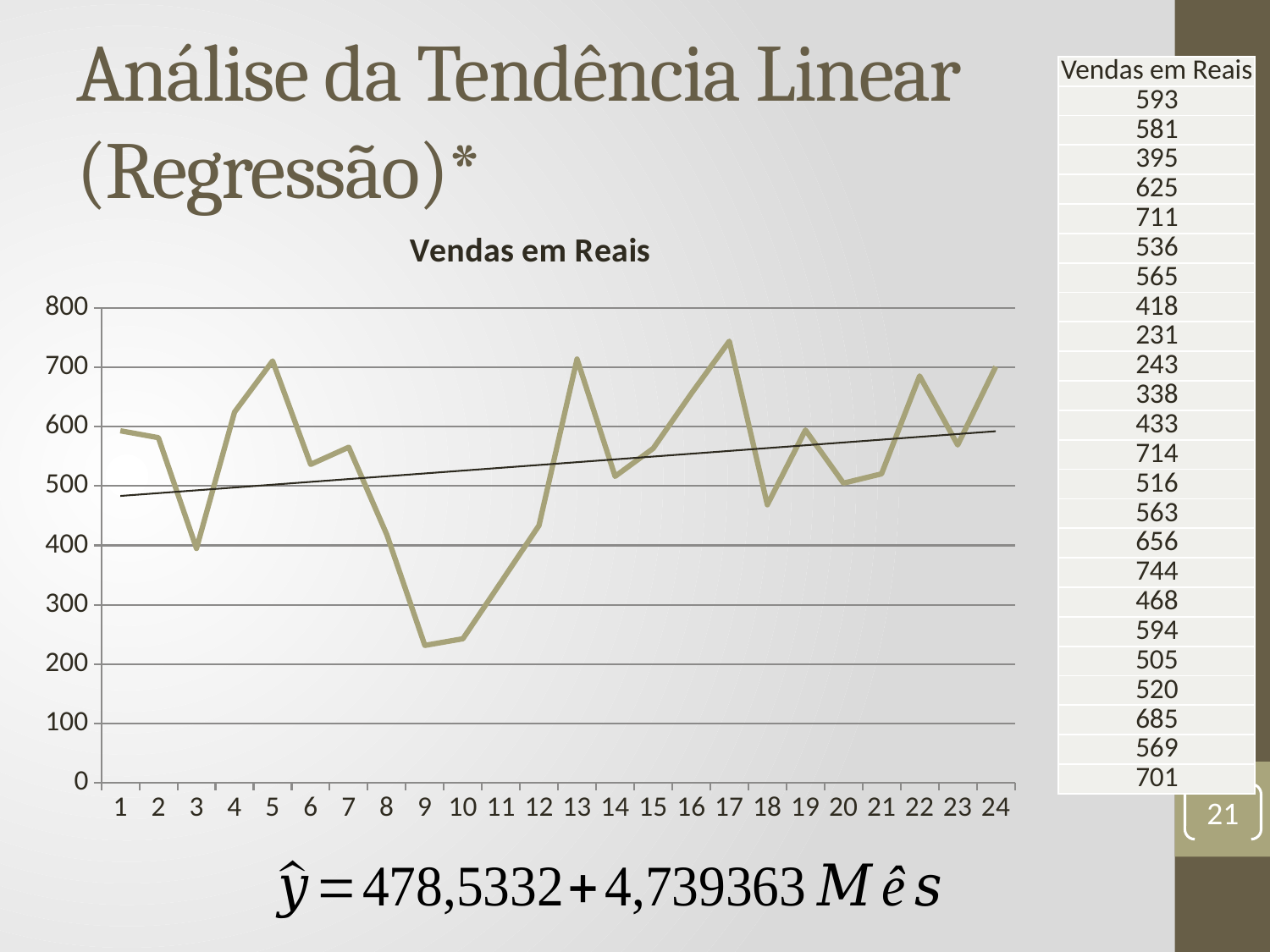
According to the table of values on the slide, what is the value of Vendas em Reais at point 17? 744 What kind of chart is shown on the slide? line chart Is the value at point 5 greater or less than 600? greater At which x-axis value does the line reach its lowest point? 9 Using the values listed on the slide, what is the difference between the value at point 17 and the value at point 9? 513 At which x-axis value does the line reach its highest point? 17 How many points (months) are plotted along the x axis of the chart? 24 According to the table of values on the slide, what is the value of Vendas em Reais at point 9? 231 Which point has the larger value, 13 or 14? 13 What is the title of the chart? Vendas em Reais Does the straight trend line drawn on the chart rise or fall from left to right? rise Is the value at point 10 greater or less than 300? less